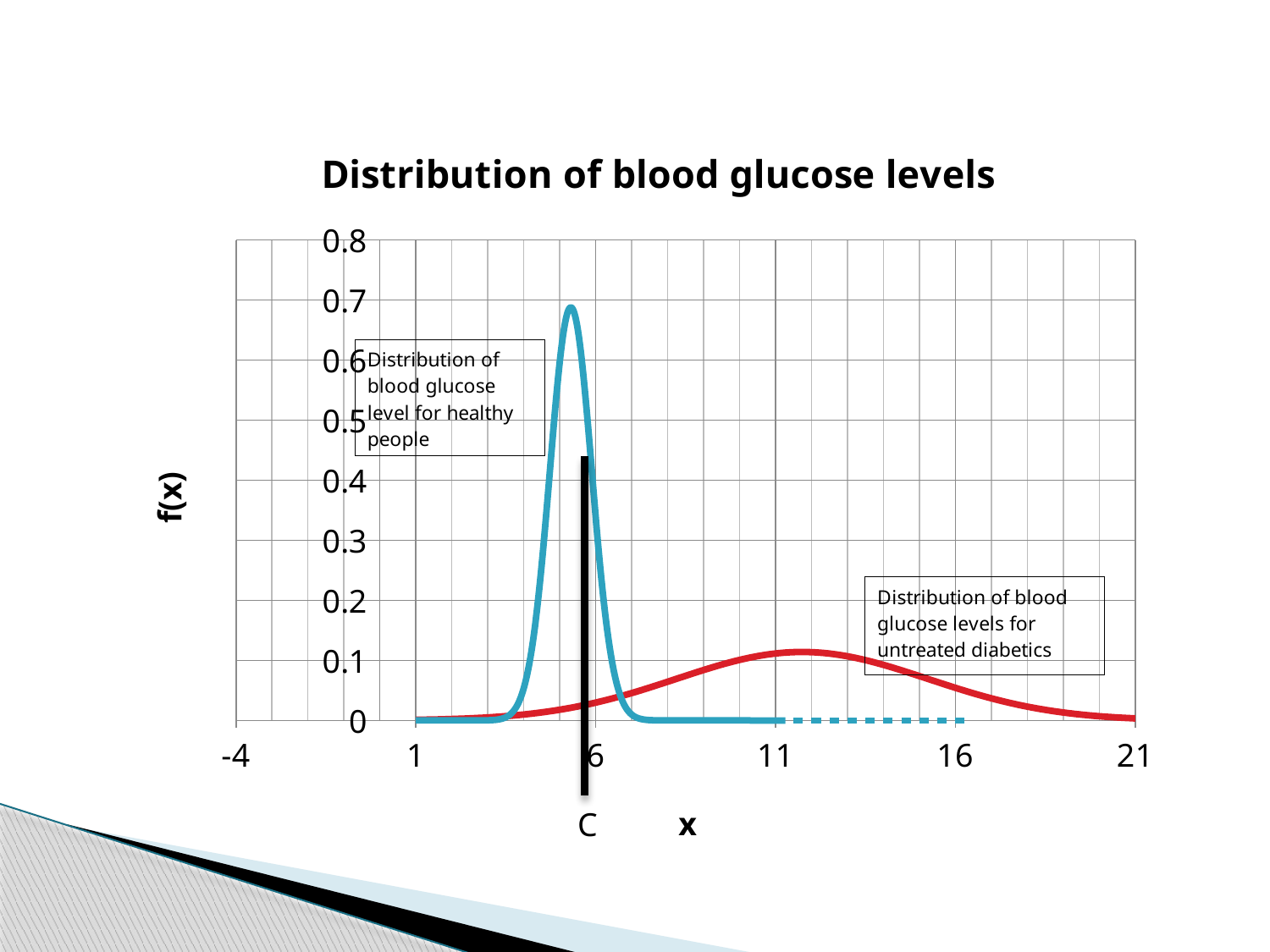
Which curve reaches the higher peak value of f(x): the healthy people curve or the untreated diabetics curve? healthy people Is the peak value of the healthy people curve greater or less than 0.6? greater What kind of chart is shown on the slide? line chart What colour is the curve for the distribution of blood glucose level for healthy people? blue Is the value of the healthy people curve at x = 11 greater or less than 0.1? less Is the peak value of the untreated diabetics curve greater or less than 0.2? less What is the title of the chart? Distribution of blood glucose levels What is the highest tick value shown on the f(x) axis? 0.8 What is the lowest tick value shown on the x axis? -4 Which curve peaks at a larger value of x: the healthy people curve or the untreated diabetics curve? untreated diabetics How many distribution curves are plotted on the chart? 2 Does the untreated diabetics curve rise or fall between x = 16 and x = 21? fall